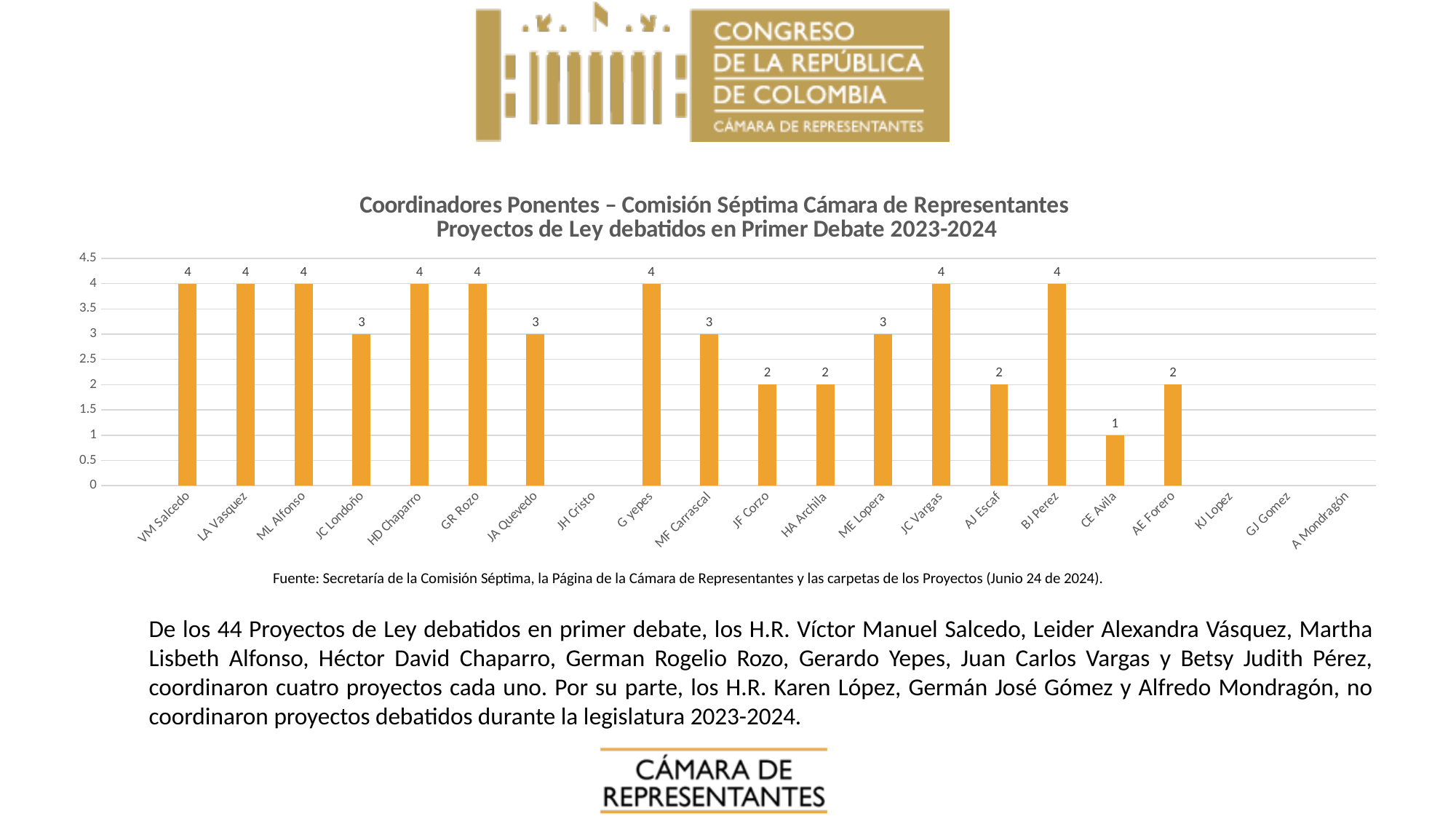
What kind of chart is shown on the slide? bar chart What is the value for JC Londoño? 3 What is the difference between the values for VM Salcedo and CE Avila? 3 What is the value for CE Avila? 1 What is the value for ME Lopera? 3 Which is larger, the value for HD Chaparro or the value for HA Archila? HD Chaparro What is the value for BJ Perez? 4 How many categories are shown on the x axis? 21 What is the first line of the chart title? Coordinadores Ponentes – Comisión Séptima Cámara de Representantes Which is larger, the value for AJ Escaf or the value for JA Quevedo? JA Quevedo What is the value for AE Forero? 2 What is the difference between the values for MF Carrascal and JF Corzo? 1